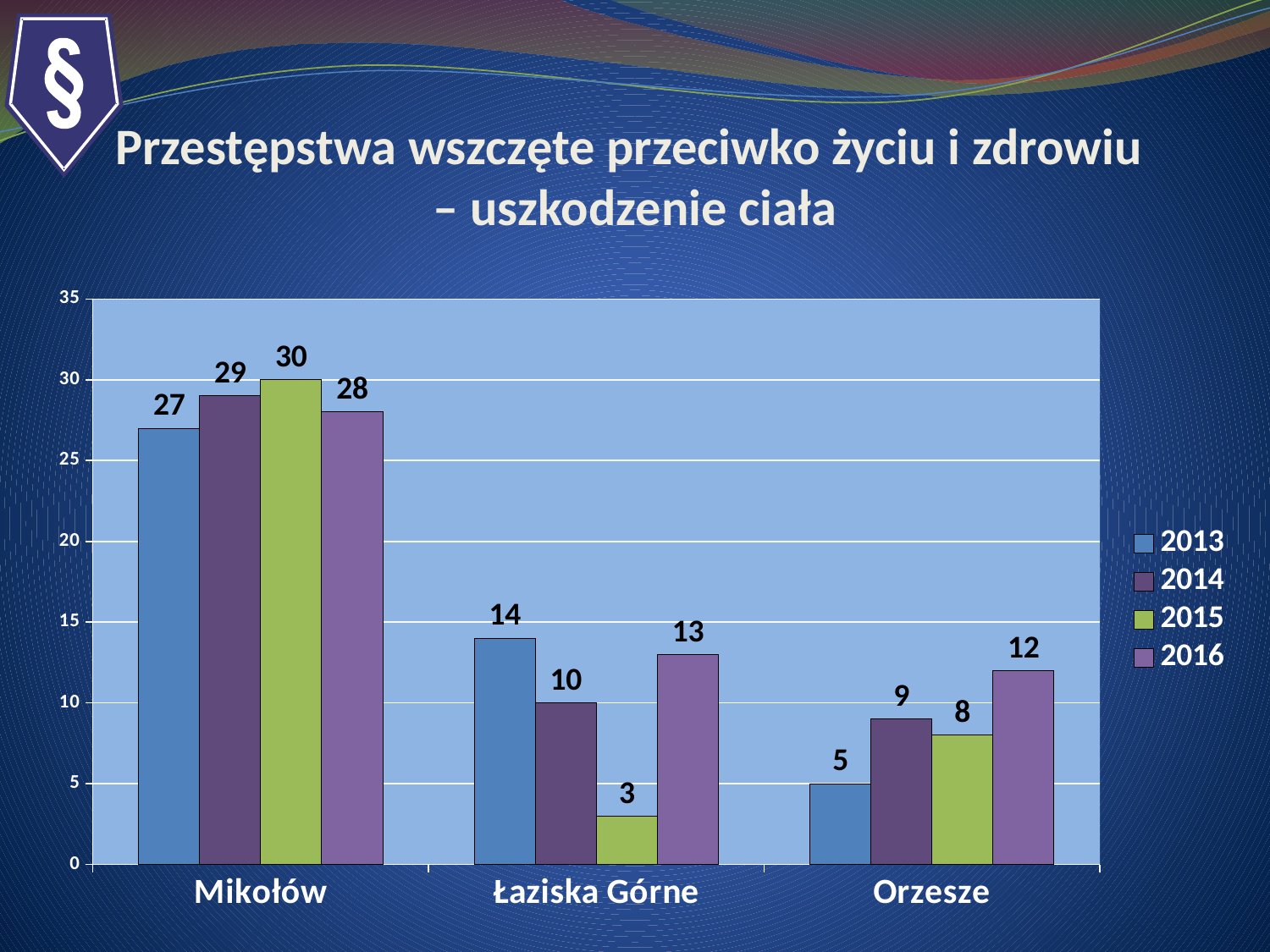
Which is larger: the 2014 value for Orzesze or the 2015 value for Orzesze? 2014 What is the value for Orzesze in 2016? 12 What is the difference between the 2016 and 2015 values for Łaziska Górne? 10 How many categories are shown on the x axis? 3 What is the value for Mikołów in 2015? 30 Which year does the green series represent in the legend? 2015 How many series does the legend list? 4 What kind of chart is shown on the slide? bar chart Is the value for Mikołów in 2013 greater or less than 25? greater Which category has the lowest value in 2015? Łaziska Górne Which category has the highest value in 2014? Mikołów What is the value for Łaziska Górne in 2013? 14